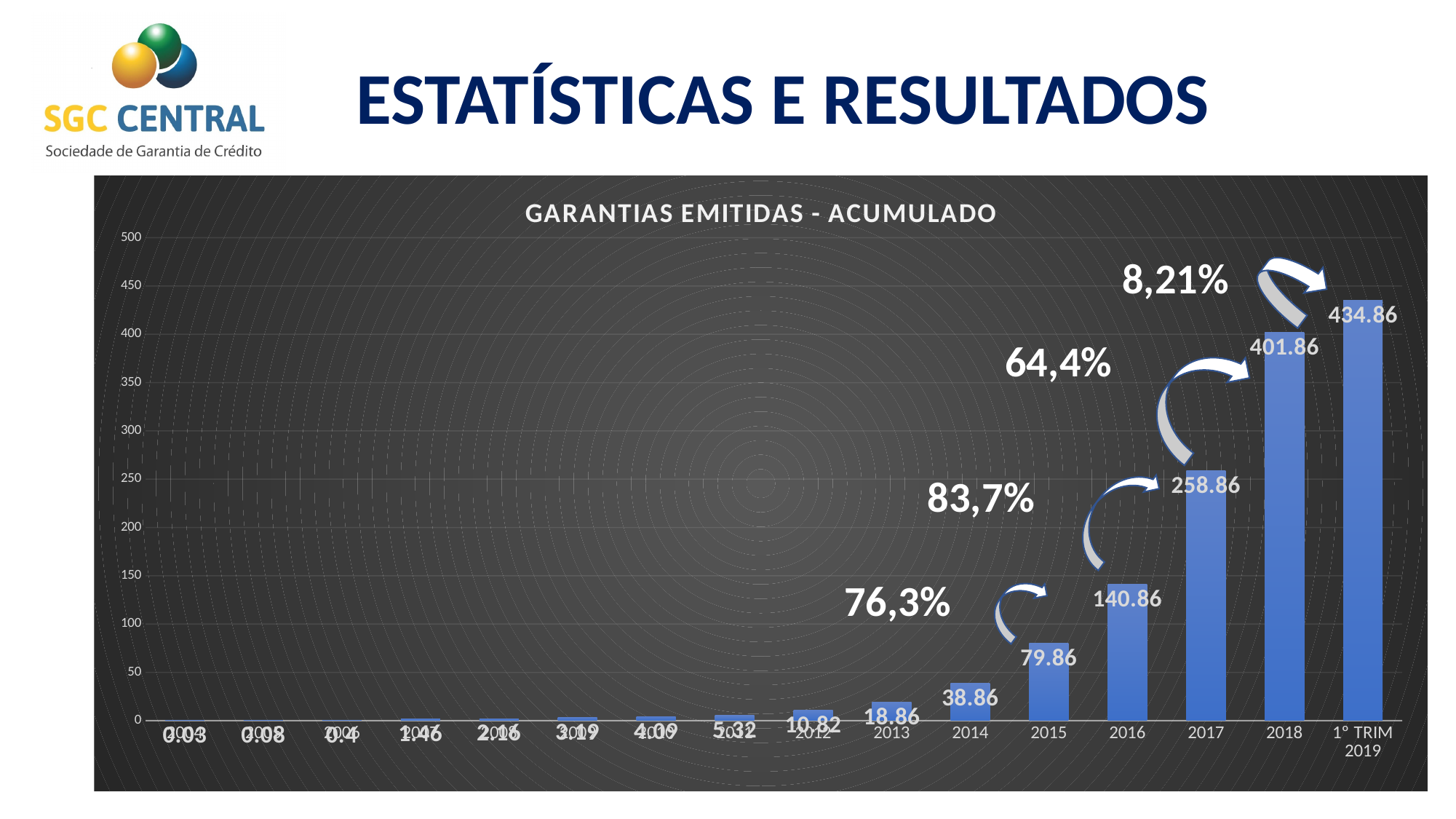
Which category has the highest value? 1º TRIM 2019 What is the title of the chart? GARANTIAS EMITIDAS - ACUMULADO What kind of chart is shown on the slide? bar chart Do the values rise or fall from 2012 to 1º TRIM 2019? rise What is the difference between the values for 2017 and 2016? 118 What is the difference between the values for 1º TRIM 2019 and 2018? 33 Is the value for 2017 greater or less than 250? greater What is the value for 2016? 140.86 What is the value for 2018 in the GARANTIAS EMITIDAS - ACUMULADO chart? 401.86 Which is larger, the value for 2015 or the value for 2014? 2015 What is the value for 1º TRIM 2019? 434.86 What is the value for 2013? 18.86